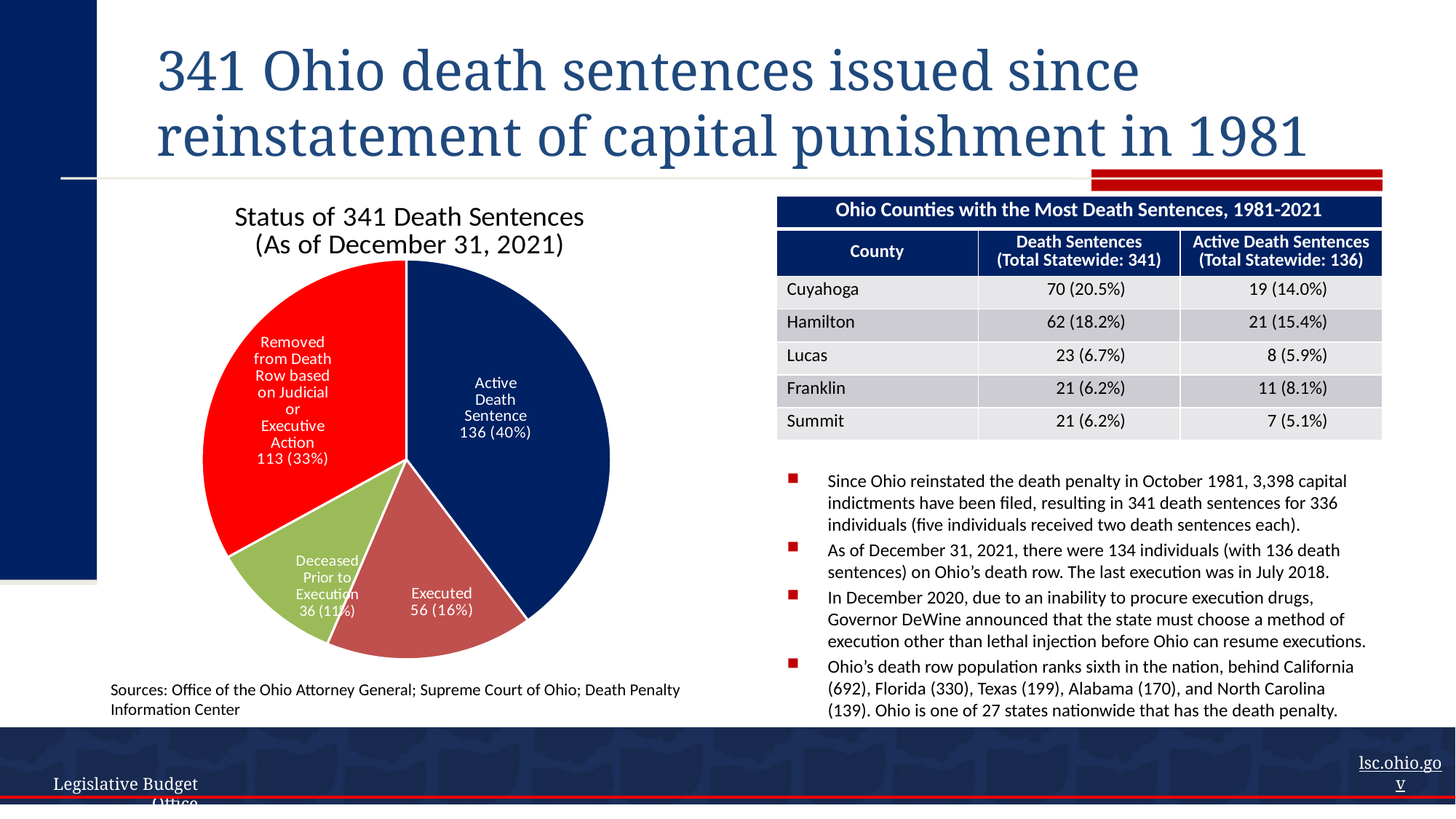
Which slice of the pie chart is the largest? Active Death Sentence How many death sentences were Removed from Death Row based on Judicial or Executive Action? 113 How many slices does the pie chart have? 4 What type of chart is shown on the slide? Pie chart What share of the pie does the Executed slice represent? 16% Which is larger: the Executed slice or the Removed from Death Row based on Judicial or Executive Action slice? Removed from Death Row based on Judicial or Executive Action How many death sentences are shown as Active Death Sentence in the pie chart? 136 What is the difference between the number of Active Death Sentences and the number Executed? 80 What is the title of the pie chart? Status of 341 Death Sentences (As of December 31, 2021) Which slice of the pie chart is the smallest? Deceased Prior to Execution How many death sentences are in the Deceased Prior to Execution slice? 36 What share of the pie does the Active Death Sentence slice represent? 40%